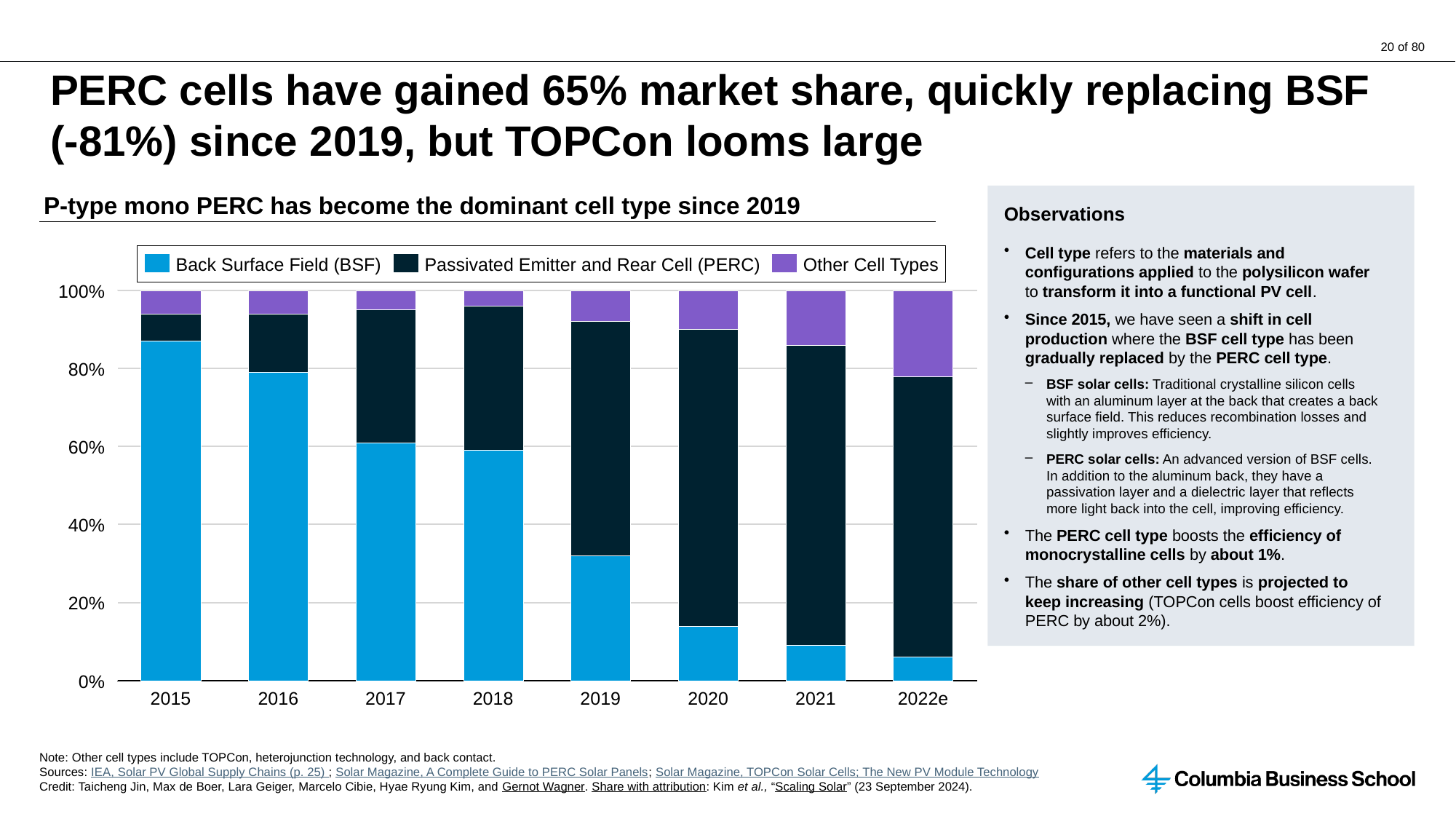
How many series does the chart's legend list? 3 Is the Back Surface Field (BSF) share in 2019 greater or less than 40%? less Does the Back Surface Field (BSF) share rise or fall from 2015 to 2022e? fall Is the Back Surface Field (BSF) share in 2015 greater or less than 80%? greater Which year has the highest share for Back Surface Field (BSF)? 2015 What kind of chart is shown on the slide? Stacked bar chart How many years (categories) are shown on the x axis of the chart? 8 Which year has the lowest share for Back Surface Field (BSF)? 2022e Which year has the larger Back Surface Field (BSF) share, 2016 or 2018? 2016 What is the total of the stacked bar for 2015? 100% What is the title of the chart? P-type mono PERC has become the dominant cell type since 2019 Is the Back Surface Field (BSF) share in 2020 greater or less than 20%? less